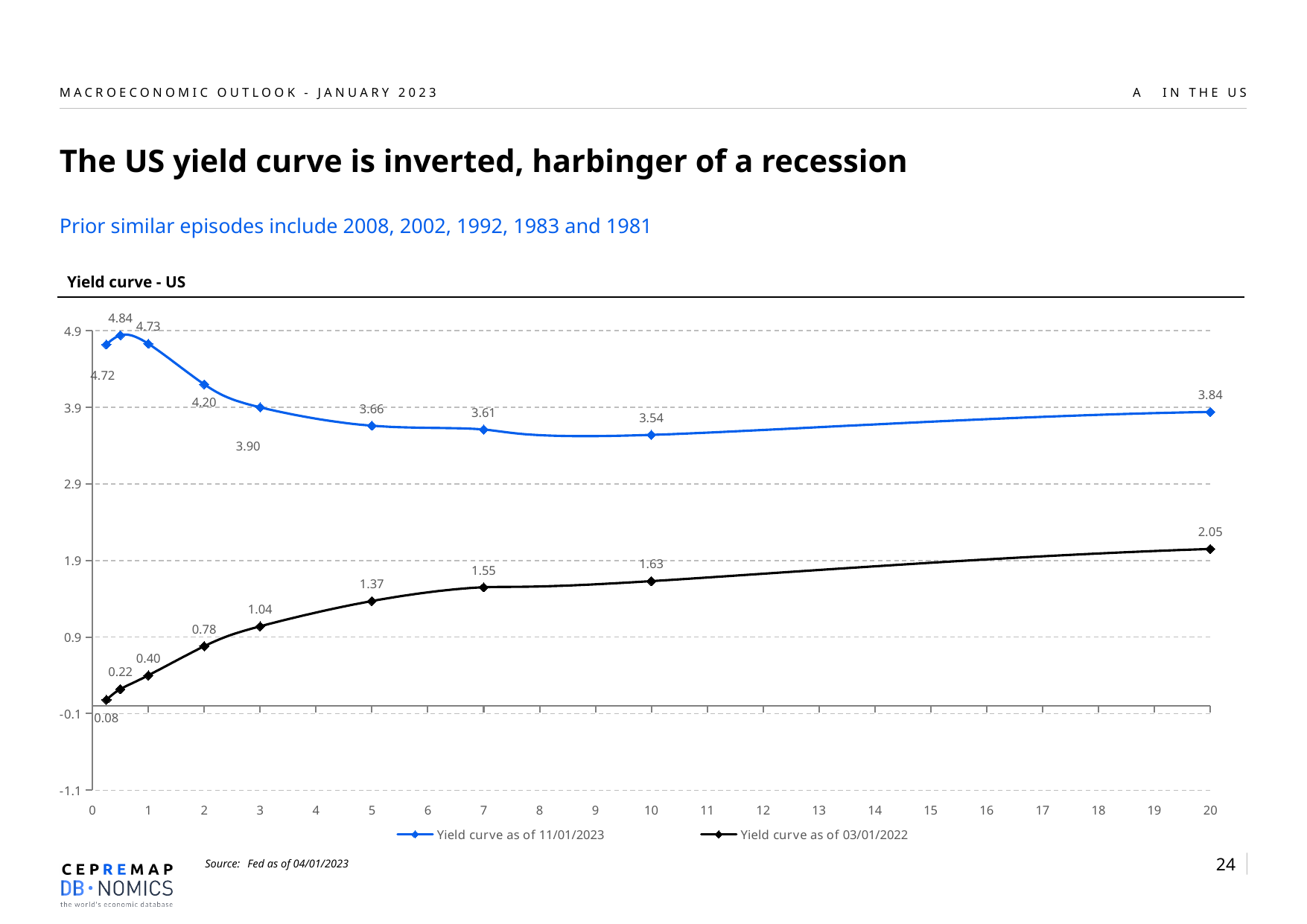
On the Yield curve - US chart, what is the difference between the 'Yield curve as of 11/01/2023' values at maturity 1 and maturity 10? 1.19 What kind of chart is the Yield curve - US chart? Line chart How many series does the legend of the Yield curve - US chart list? 2 On the Yield curve - US chart, what is the highest labeled value of the 'Yield curve as of 11/01/2023' series? 4.84 On the Yield curve - US chart, which series has the higher value at maturity 5? Yield curve as of 11/01/2023 On the Yield curve - US chart, at which maturity does the 'Yield curve as of 03/01/2022' series reach its highest value? 20 On the Yield curve - US chart, what is the value of the 'Yield curve as of 11/01/2023' series at maturity 20? 3.84 On the Yield curve - US chart, what is the lowest labeled value of the 'Yield curve as of 11/01/2023' series? 3.54 On the Yield curve - US chart, what is the value of the 'Yield curve as of 03/01/2022' series at maturity 10? 1.63 On the Yield curve - US chart, does the 'Yield curve as of 03/01/2022' series rise or fall as maturity increases? Rises On the Yield curve - US chart, what is the difference between the two series at maturity 20? 1.79 On the Yield curve - US chart, what is the value of the 'Yield curve as of 03/01/2022' series at maturity 2? 0.78